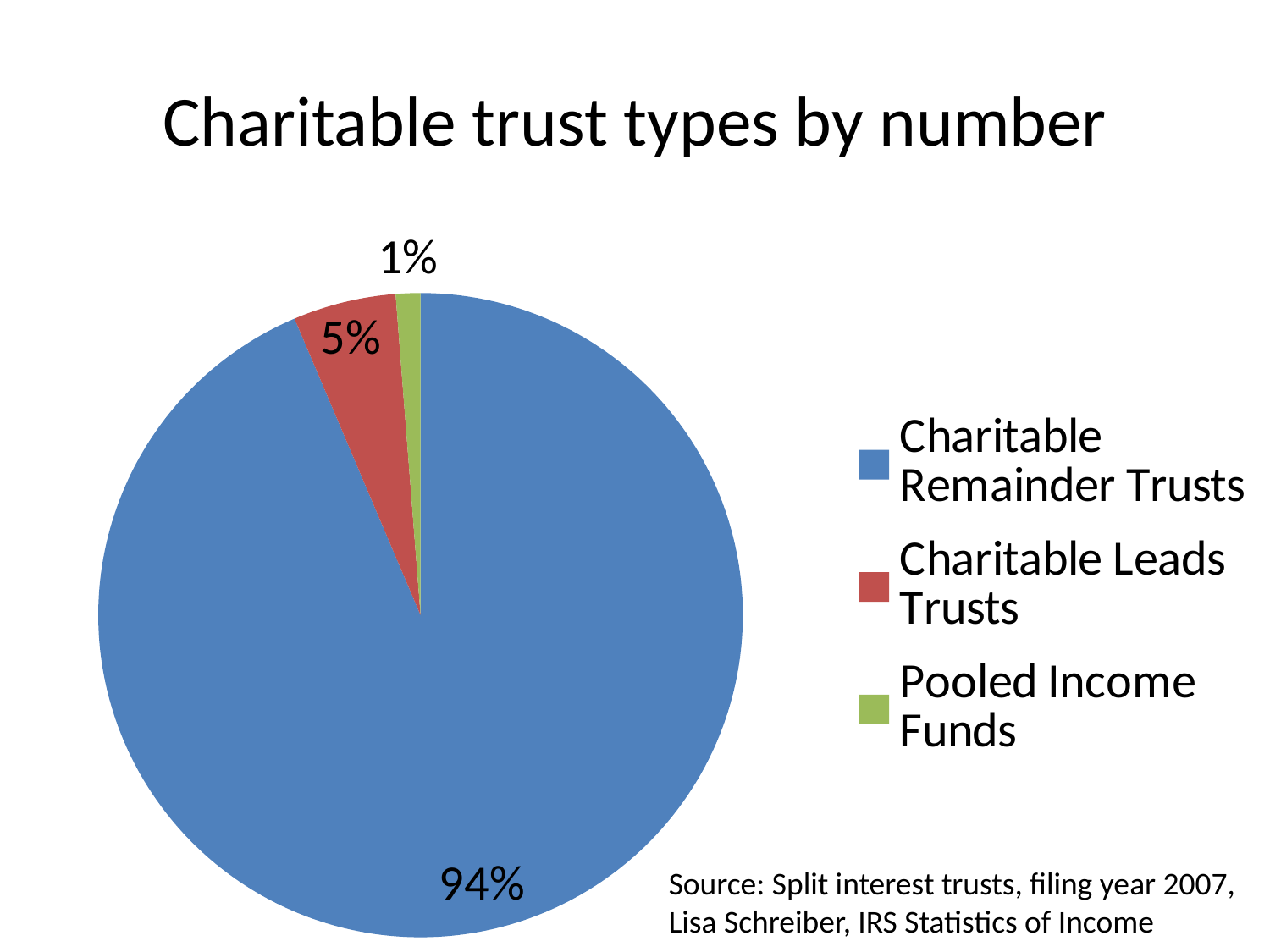
Which trust type has the largest slice of the pie? Charitable Remainder Trusts Which trust type has the smallest slice of the pie? Pooled Income Funds What is the title of the chart? Charitable trust types by number What type of chart is shown on the slide? pie chart How many slices does the pie chart have? 3 What share of the pie do Pooled Income Funds represent? 1% What share of the pie do Charitable Leads Trusts represent? 5% What share of the pie do Charitable Remainder Trusts represent? 94% What colour is the slice for Charitable Leads Trusts? red Which is larger, the share for Charitable Leads Trusts or the share for Pooled Income Funds? Charitable Leads Trusts How many entries does the legend list? 3 What is the difference in percentage points between Charitable Remainder Trusts and Charitable Leads Trusts? 89%